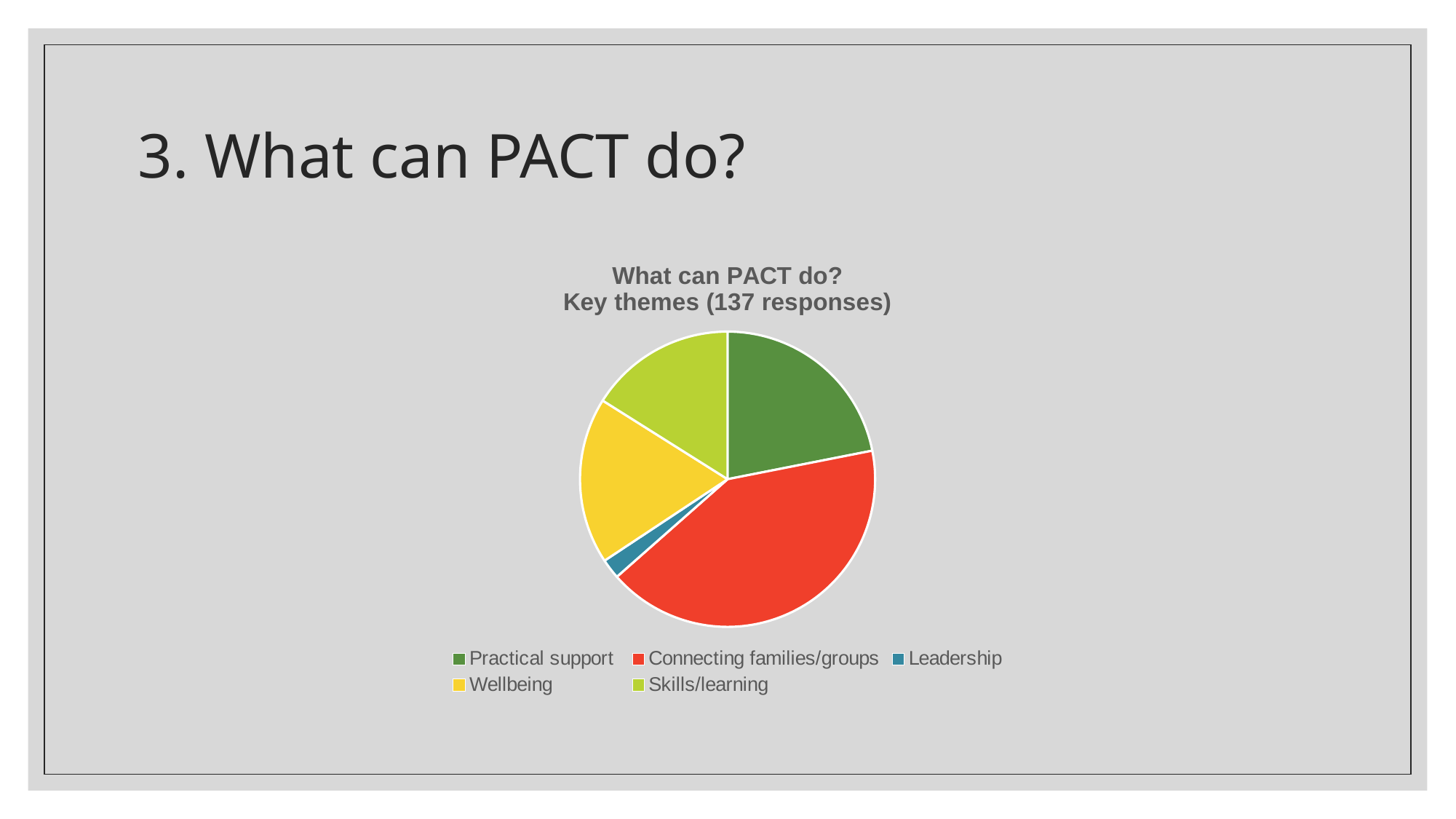
Which slice is larger: Leadership or Wellbeing? Wellbeing What colour is the Leadership slice in the pie chart? Blue Which category has the smallest slice of the pie chart? Leadership What kind of chart is shown on the slide? Pie chart How many categories (slices) does the pie chart have? 5 Which slice is larger: Skills/learning or Connecting families/groups? Connecting families/groups Which slice is larger: Connecting families/groups or Practical support? Connecting families/groups How many responses does the chart title say the key themes are based on? 137 Which category has the largest slice of the pie chart? Connecting families/groups